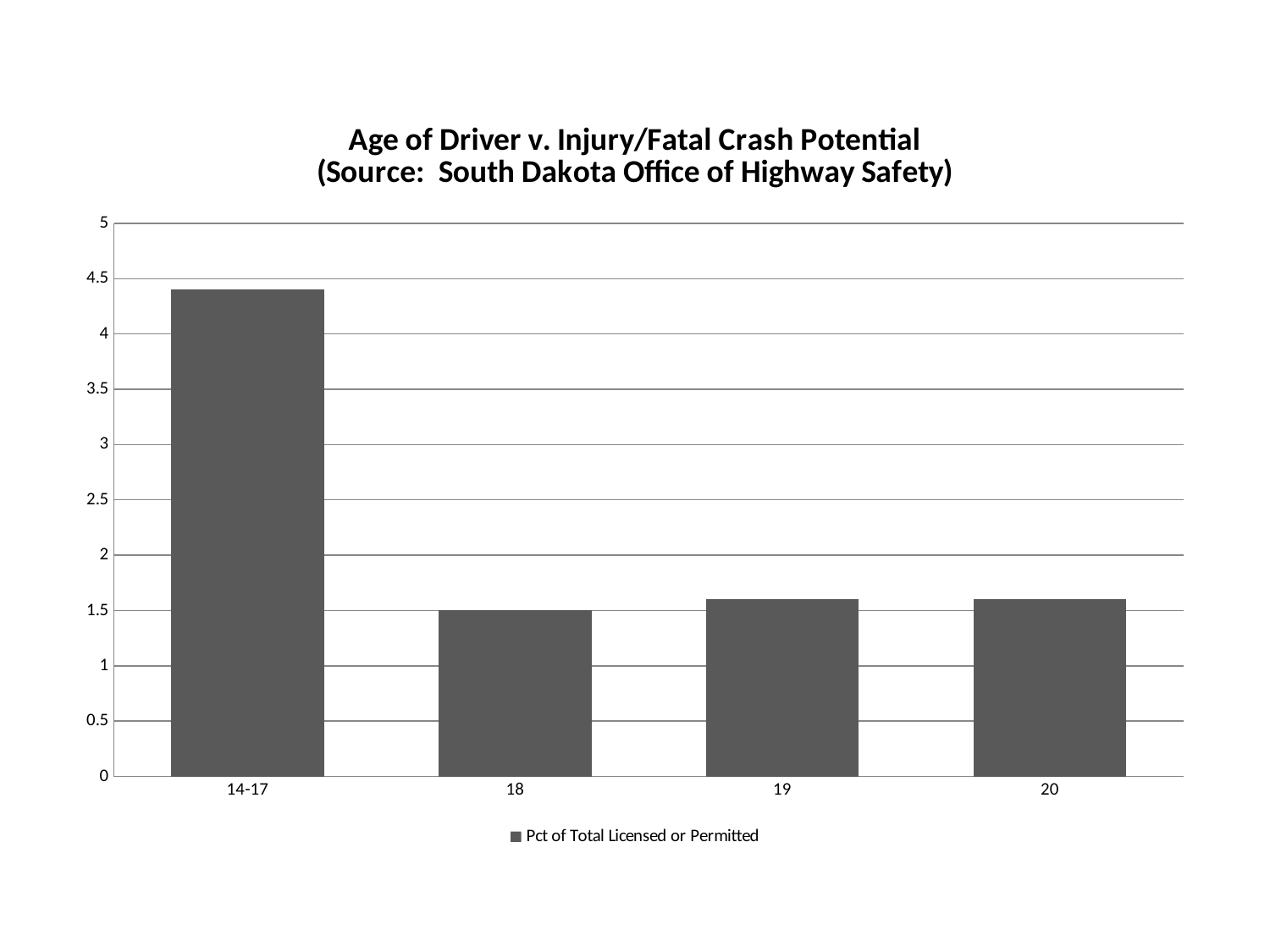
What is the value for age 18? 1.5 Is the value for 14-17 greater or less than 4.5? less How many age categories are shown on the x axis? 4 Is the value for 14-17 greater or less than 4? greater What source is cited in the chart title? South Dakota Office of Highway Safety Is the value for 20 greater or less than 1? greater What kind of chart is shown on the slide? bar chart What series name is shown in the legend? Pct of Total Licensed or Permitted How many series does the legend list? 1 Which age group has the highest value? 14-17 Which is larger, the value for 14-17 or the value for 18? 14-17